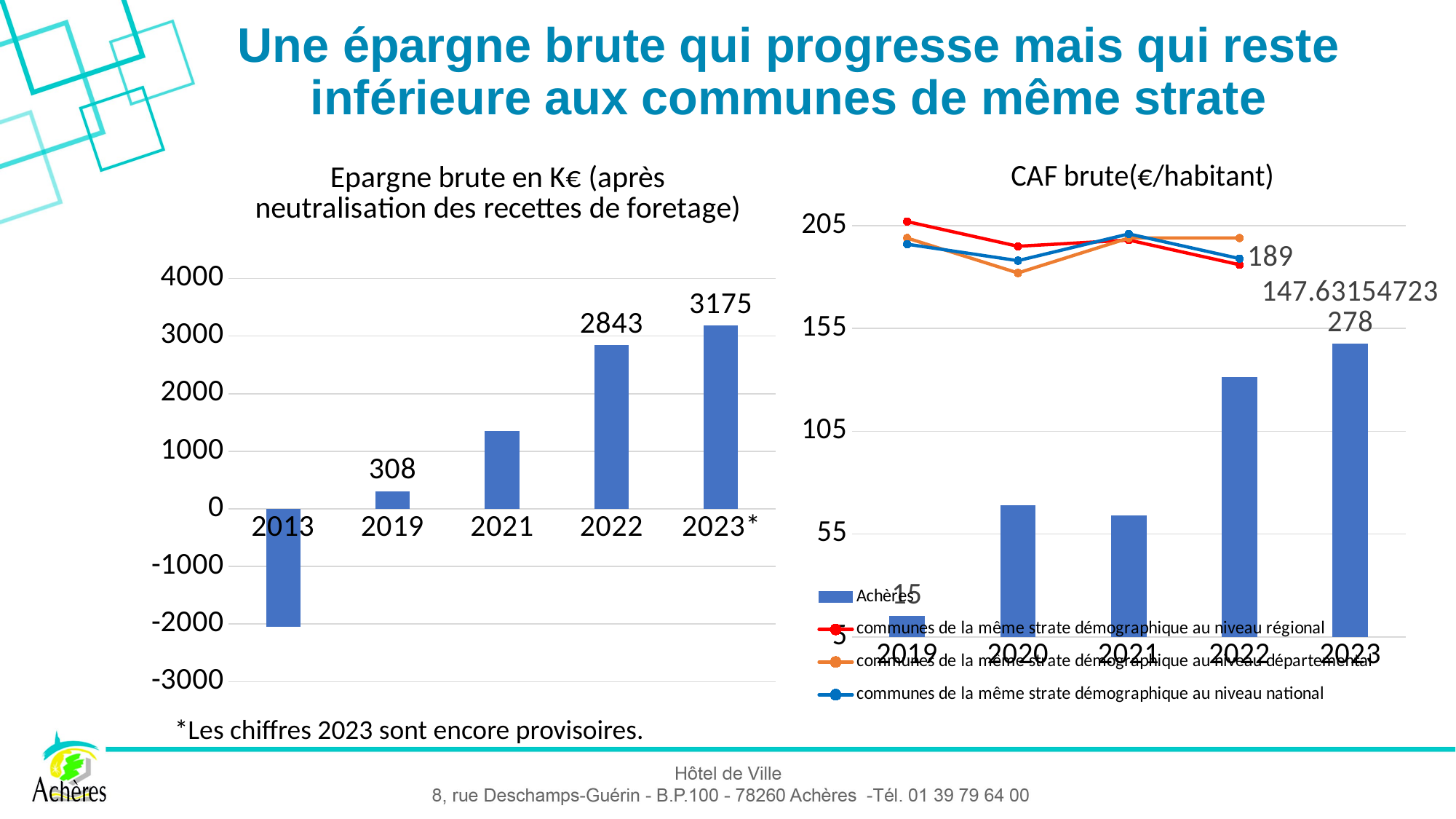
On the left chart (Epargne brute en K€), what is the value for 2019? 308 On the left chart (Epargne brute en K€), what is the value for 2023*? 3175 On the right chart (CAF brute €/habitant), is the Achères bar for 2020 greater or less than 105? less On the left chart (Epargne brute en K€), which year has the highest value? 2023* On the left chart (Epargne brute en K€), what is the value for 2022? 2843 On the left chart (Epargne brute en K€), what is the difference between the 2023* and 2022 values? 332 On the right chart (CAF brute €/habitant), how many years are shown on the x axis? 5 On the left chart (Epargne brute en K€), is the value for 2013 greater or less than -1000? less On the left chart (Epargne brute en K€), is the value for 2021 greater or less than 1000? greater On the left chart (Epargne brute en K€), which year has the lowest value? 2013 On the right chart (CAF brute €/habitant), how many series does the legend list? 4 What kind of chart is the left chart (Epargne brute en K€)? bar chart